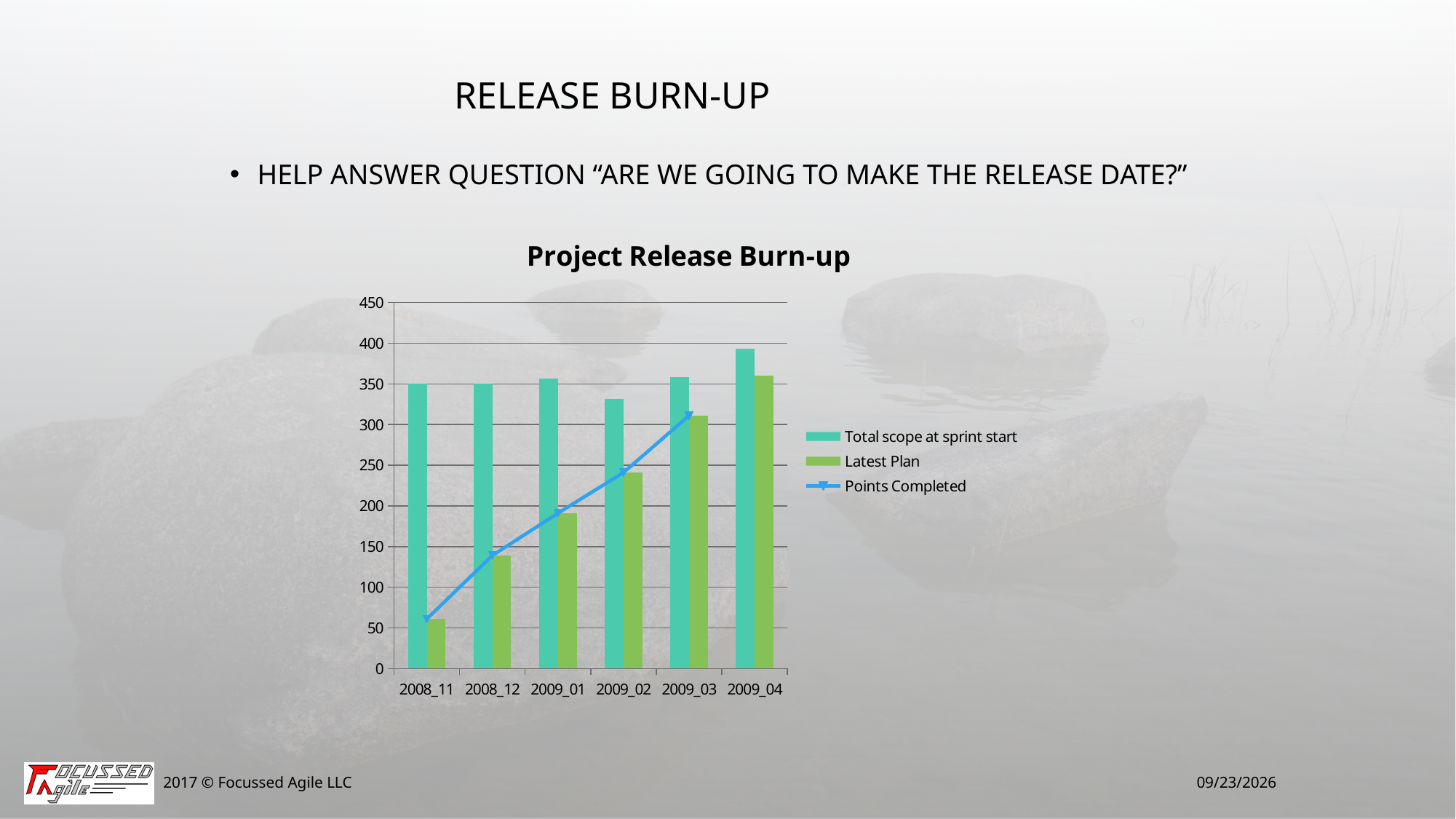
Which series in the legend is drawn as a line rather than bars? Points Completed In 2008_12, which is larger: Total scope at sprint start or Latest Plan? Total scope at sprint start What is the title of the chart on the slide? Project Release Burn-up Is the value for Total scope at sprint start in 2009_02 greater or less than 350? less Do the Points Completed values rise or fall along the x axis? Rise What kind of chart is the Project Release Burn-up chart? Bar chart with a line series Which category has the lowest value for Latest Plan? 2008_11 Is the value for Latest Plan in 2008_11 greater or less than 100? less Which category has the highest value for Total scope at sprint start? 2009_04 How many categories are shown on the x axis of the chart? 6 Is the value for Total scope at sprint start in 2009_04 greater or less than 350? greater How many series does the chart legend list? 3